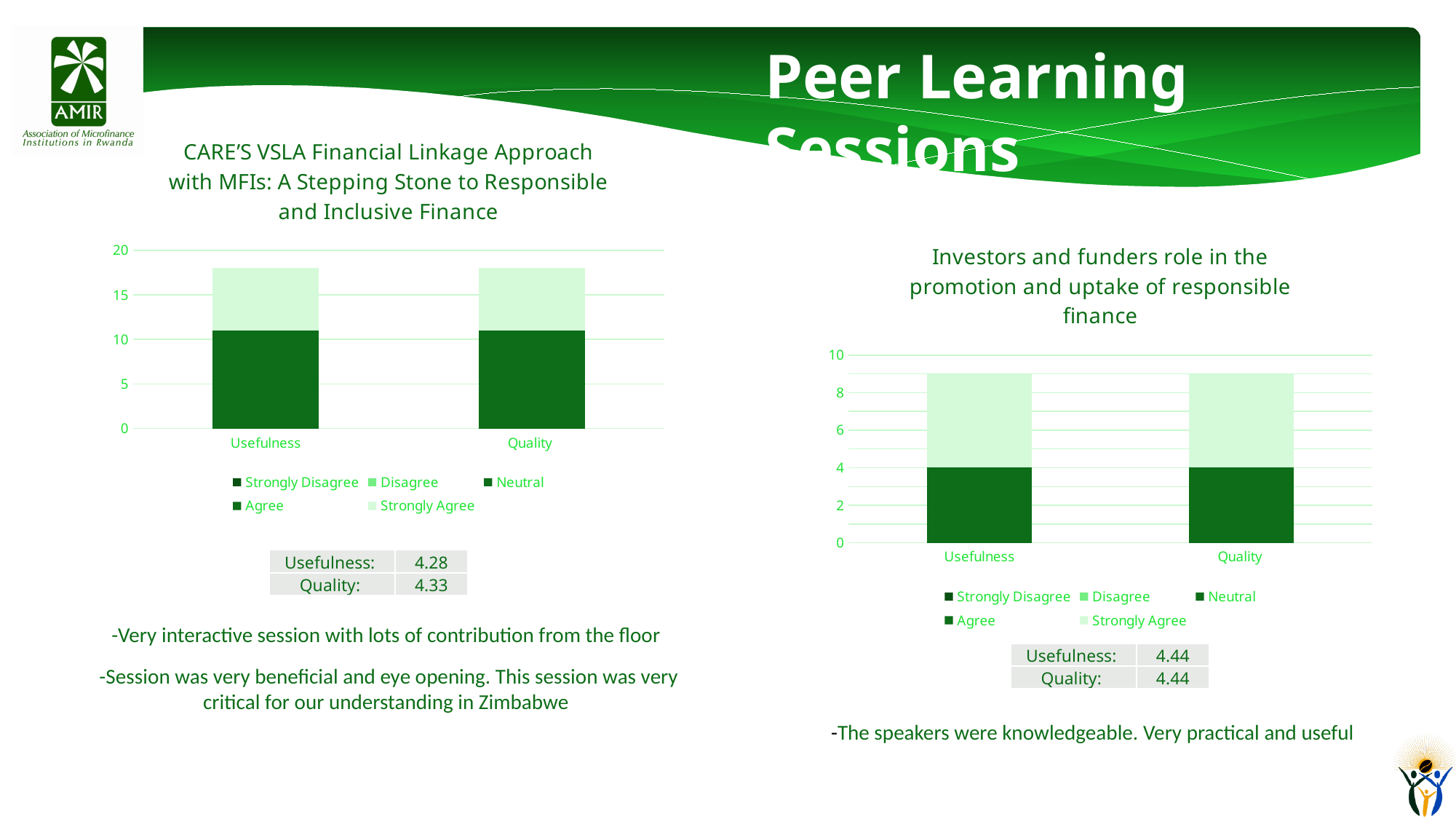
In the chart titled "Investors and funders role in the promotion and uptake of responsible finance", how many categories are shown on the x axis? 2 Which legend entry is shown in the lightest green in the chart titled "CARE'S VSLA Financial Linkage Approach with MFIs: A Stepping Stone to Responsible and Inclusive Finance"? Strongly Agree In the chart titled "Investors and funders role in the promotion and uptake of responsible finance", is the Strongly Agree segment for Usefulness greater or less than 4? greater In the chart titled "CARE'S VSLA Financial Linkage Approach with MFIs: A Stepping Stone to Responsible and Inclusive Finance", is the total height of the Usefulness bar greater or less than 15? greater In the chart titled "CARE'S VSLA Financial Linkage Approach with MFIs: A Stepping Stone to Responsible and Inclusive Finance", how many categories are shown on the x axis? 2 What kind of chart is the chart titled "CARE'S VSLA Financial Linkage Approach with MFIs: A Stepping Stone to Responsible and Inclusive Finance"? Stacked bar chart In the chart titled "Investors and funders role in the promotion and uptake of responsible finance", is the total height of the Quality bar greater or less than 8? greater How many series does the legend list in the chart titled "CARE'S VSLA Financial Linkage Approach with MFIs: A Stepping Stone to Responsible and Inclusive Finance"? 5 What is the highest value shown on the y axis of the chart on the right side of the slide? 10